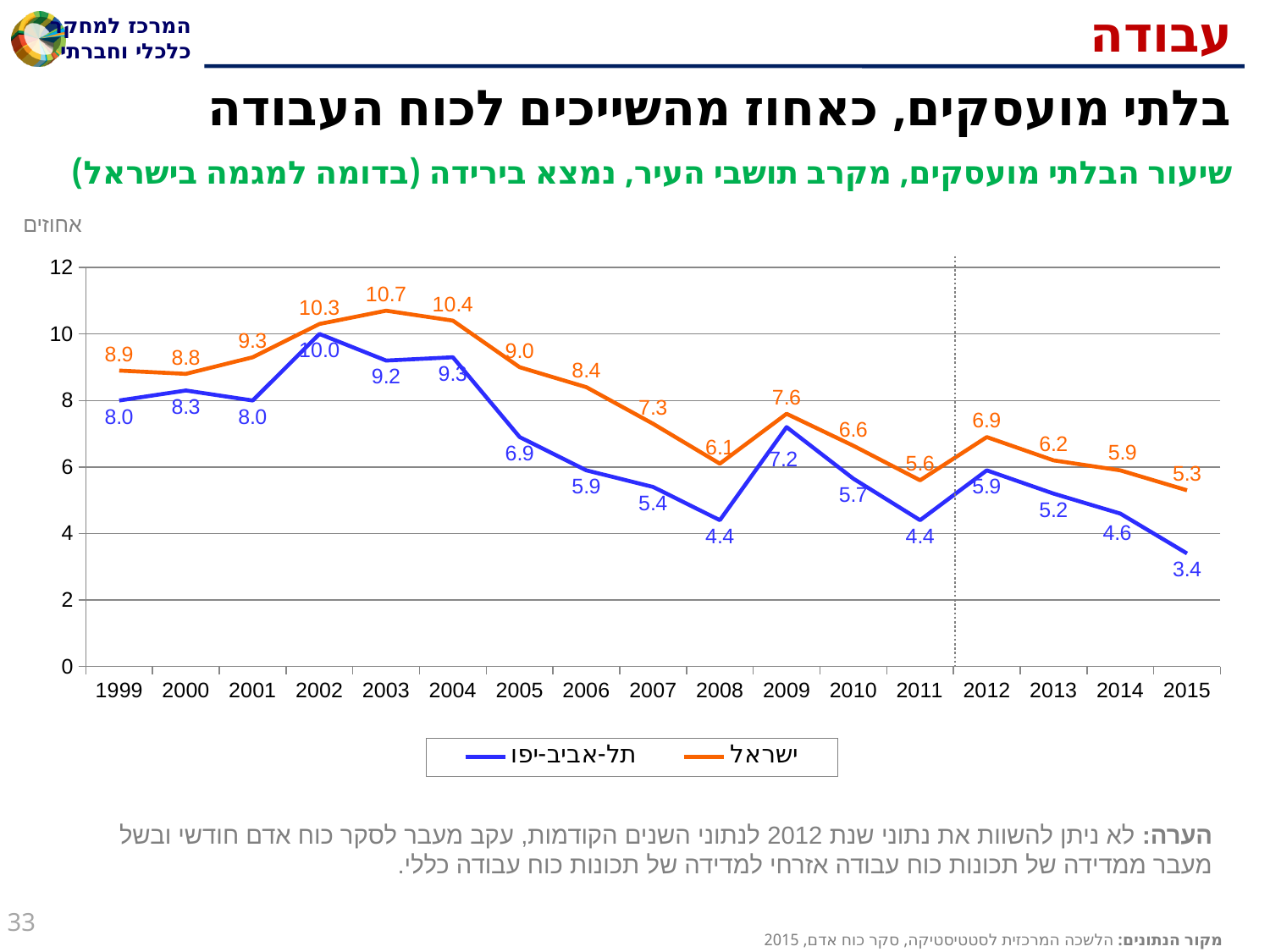
In which year is the ישראל series highest? 2003 What is the value for ישראל in 2003? 10.7 What is the value for תל-אביב-יפו in 2009? 7.2 What is the value for תל-אביב-יפו in 2015? 3.4 What is the unit label shown above the y axis? אחוזים In which year is the תל-אביב-יפו series lowest? 2015 Overall, do the תל-אביב-יפו values rise or fall from 2002 to 2015? fall How many series does the legend list? 2 Which series has the higher value in 2002, ישראל or תל-אביב-יפו? ישראל What type of chart is shown on the slide? line chart What is the difference between the ישראל and תל-אביב-יפו values in 2015? 1.9 How many years are shown on the x axis? 17